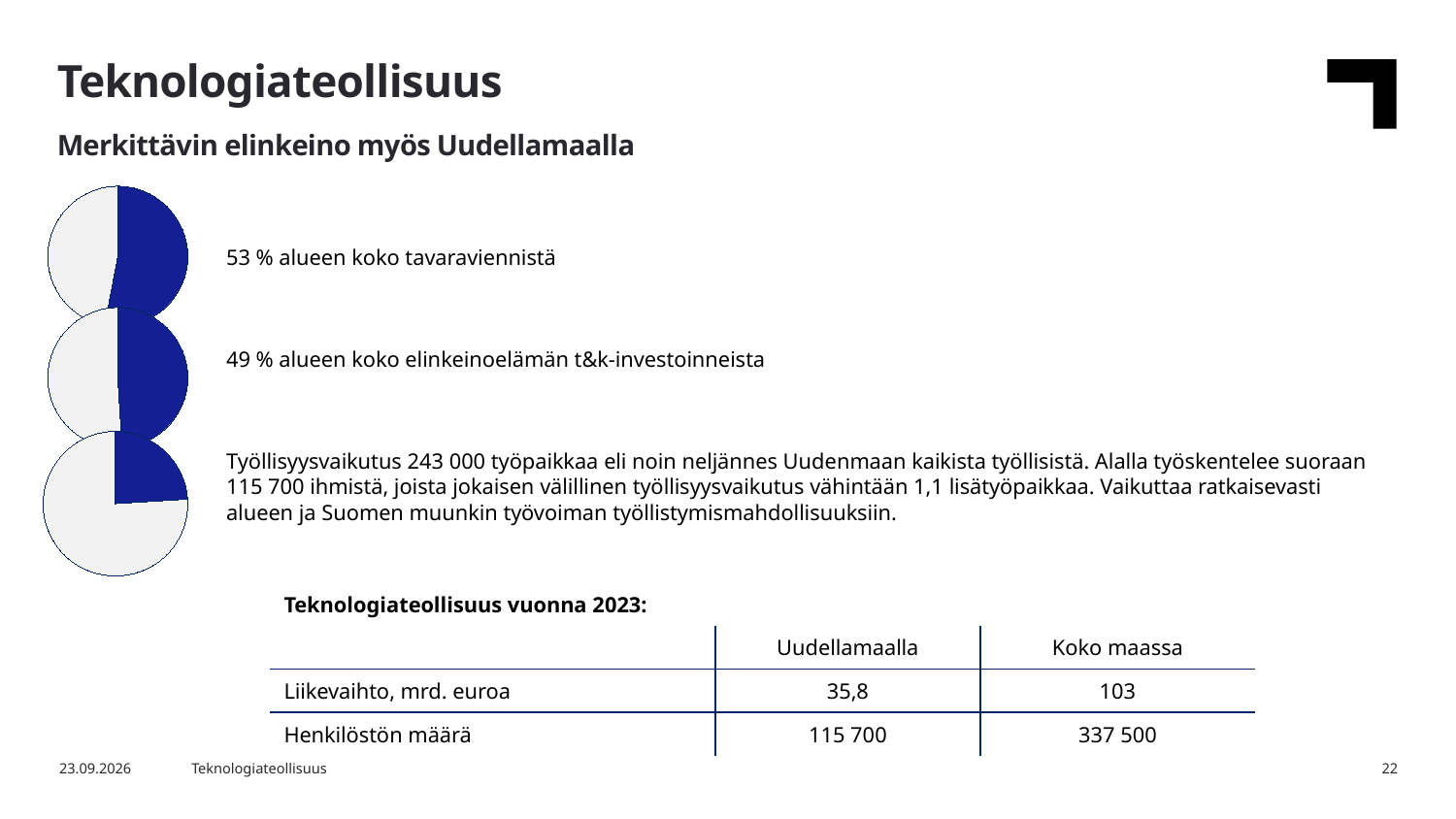
Which of the three pie charts has the smallest highlighted slice? The bottom pie chart Which has the larger highlighted slice, the top pie chart or the bottom pie chart? The top pie chart Which has the larger highlighted slice, the middle pie chart or the bottom pie chart? The middle pie chart How many pie charts are on the slide? 3 In the middle pie chart, what share of the region's business R&D investments (elinkeinoelämän t&k-investoinnit) does the highlighted slice represent? 49 % What colour is the highlighted slice in each pie chart? Blue What kind of charts are shown on the left side of the slide? Pie charts In the top pie chart, what share of the region's total goods exports (alueen koko tavaravienti) does the highlighted slice represent? 53 % What does the top pie chart's highlighted slice represent, according to the text next to it? 53 % alueen koko tavaraviennistä